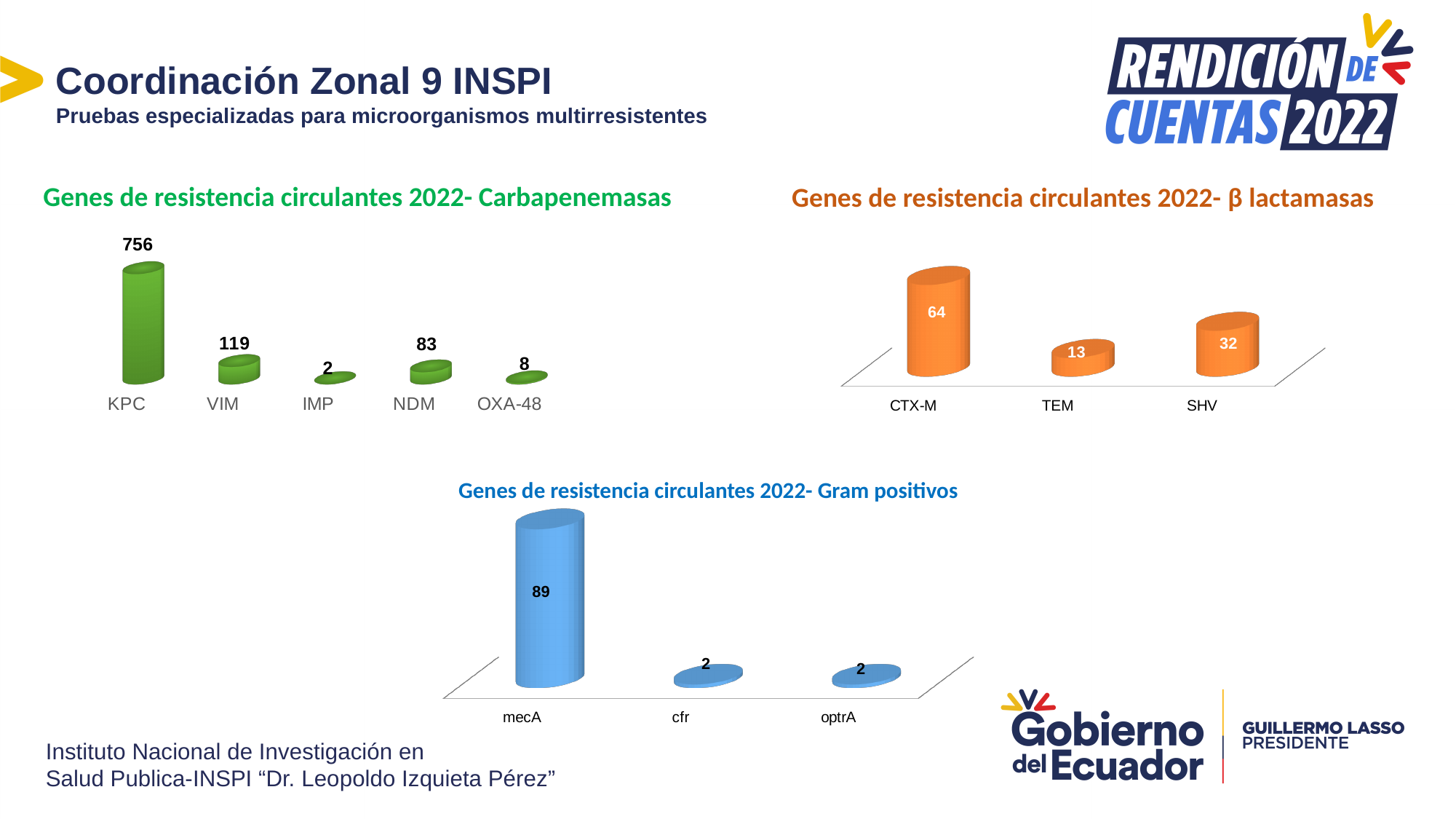
What colour are the bars in the 'Genes de resistencia circulantes 2022- β lactamasas' chart? Orange In the 'Genes de resistencia circulantes 2022- β lactamasas' chart, which category has the highest value? CTX-M In the 'Genes de resistencia circulantes 2022- β lactamasas' chart, what is the difference between the values for CTX-M and SHV? 32 In the 'Genes de resistencia circulantes 2022- Carbapenemasas' chart, what is the value for OXA-48? 8 In the 'Genes de resistencia circulantes 2022- Carbapenemasas' chart, what is the difference between the values for VIM and NDM? 36 In the 'Genes de resistencia circulantes 2022- Carbapenemasas' chart, which category has the lowest value? IMP In the 'Genes de resistencia circulantes 2022- Carbapenemasas' chart, how many categories are shown? 5 In the 'Genes de resistencia circulantes 2022- β lactamasas' chart, what is the value for TEM? 13 In the 'Genes de resistencia circulantes 2022- Carbapenemasas' chart, what is the value for KPC? 756 What kind of chart is the 'Genes de resistencia circulantes 2022- Gram positivos' chart? Bar chart In the 'Genes de resistencia circulantes 2022- Gram positivos' chart, what is the value for mecA? 89 In the 'Genes de resistencia circulantes 2022- Gram positivos' chart, which is larger, the value for mecA or the value for cfr? mecA